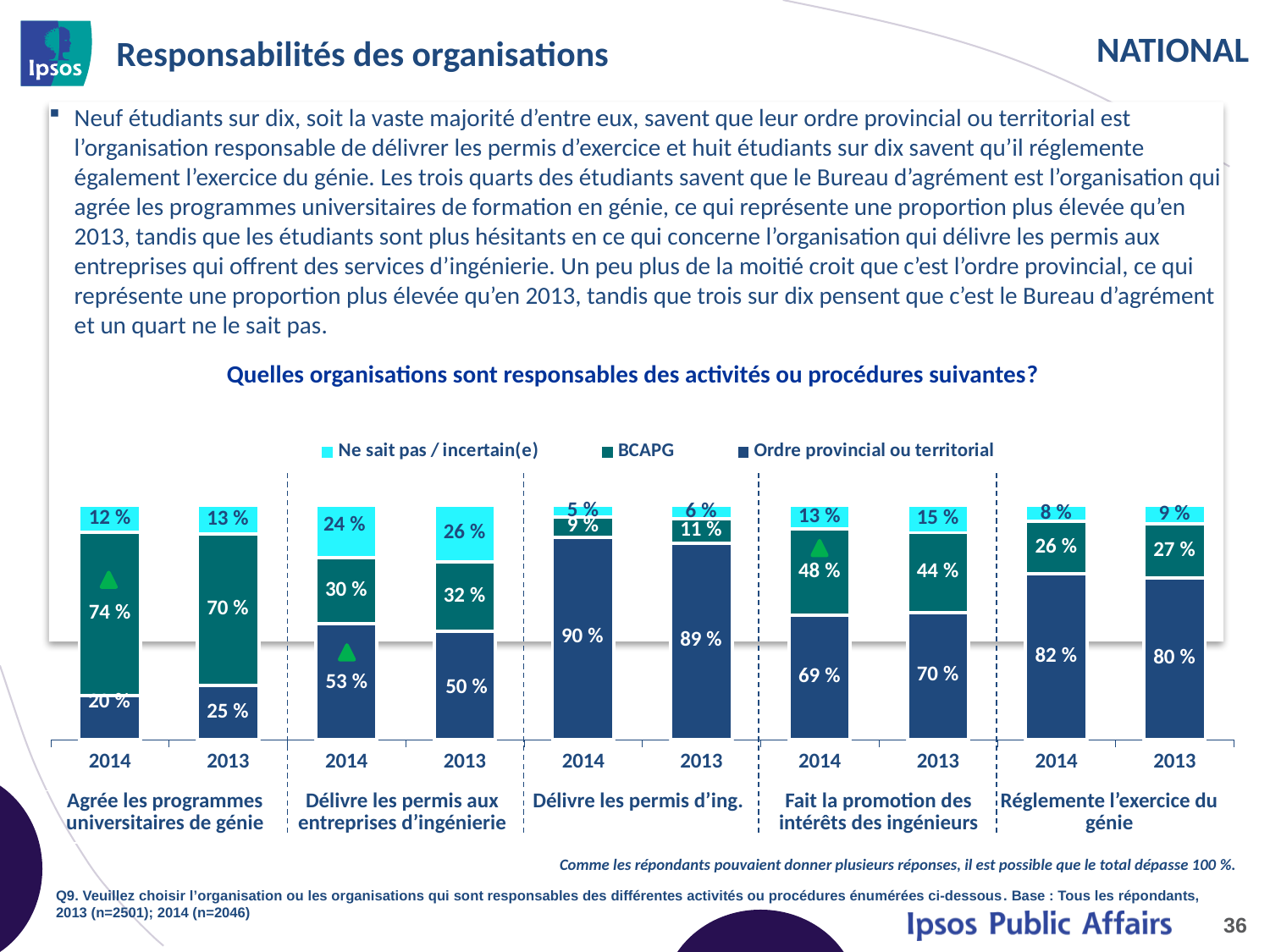
How many series does the chart legend list? 3 Which is larger: the 2014 'Ordre provincial ou territorial' value for 'Délivre les permis aux entreprises d'ingénierie' or the 2013 value? 2014 What is the value for 'Ordre provincial ou territorial' in 2014 for 'Délivre les permis d'ing.'? 90 % What is the value for 'BCAPG' in 2014 for 'Agrée les programmes universitaires de génie'? 74 % What is the difference between the 2014 and 2013 'BCAPG' values for 'Fait la promotion des intérêts des ingénieurs'? 4 % What is the total of the stacked 2014 bar for 'Agrée les programmes universitaires de génie'? 106 % Across all bars, which activity and year has the highest 'Ordre provincial ou territorial' value? Délivre les permis d'ing., 2014 What is the value for 'Ordre provincial ou territorial' in 2013 for 'Réglemente l'exercice du génie'? 80 % How many activities (category groups) are shown on the x axis? 5 What is the value for 'Ne sait pas / incertain(e)' in 2013 for 'Délivre les permis aux entreprises d'ingénierie'? 26 % What kind of chart is shown on the slide? Stacked bar chart Across all bars, which activity and year has the lowest 'Ne sait pas / incertain(e)' value? Délivre les permis d'ing., 2014